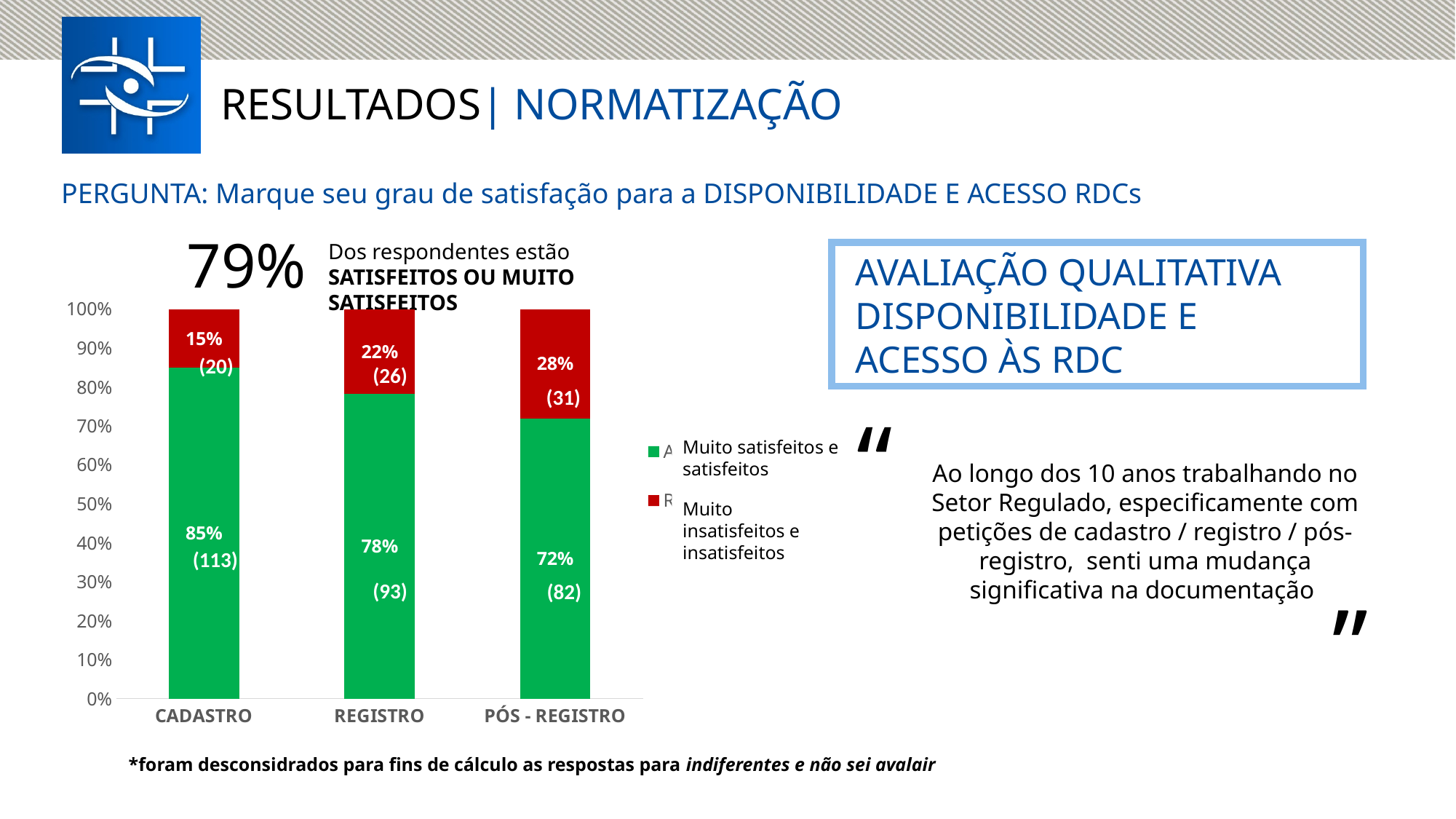
What percentage of respondents were satisfied or very satisfied (green segment) for CADASTRO? 85% Which category has the highest share of satisfied or very satisfied respondents? CADASTRO Which is larger: the dissatisfied share for REGISTRO or for CADASTRO? REGISTRO Is the satisfied share for REGISTRO greater or less than 70%? greater How many series does the chart's legend list? 2 How many categories are shown on the x axis of the chart? 3 What kind of chart is shown on the slide? Stacked bar chart Which category has the lowest share of satisfied or very satisfied respondents? PÓS - REGISTRO How many respondents (count in parentheses) were satisfied or very satisfied for REGISTRO? 93 What is the difference in percentage points between the satisfied share for CADASTRO and for PÓS - REGISTRO? 13 percentage points What percentage of respondents were dissatisfied or very dissatisfied (red segment) for PÓS - REGISTRO? 28% Does the satisfied (green) share rise or fall from CADASTRO to PÓS - REGISTRO? Fall